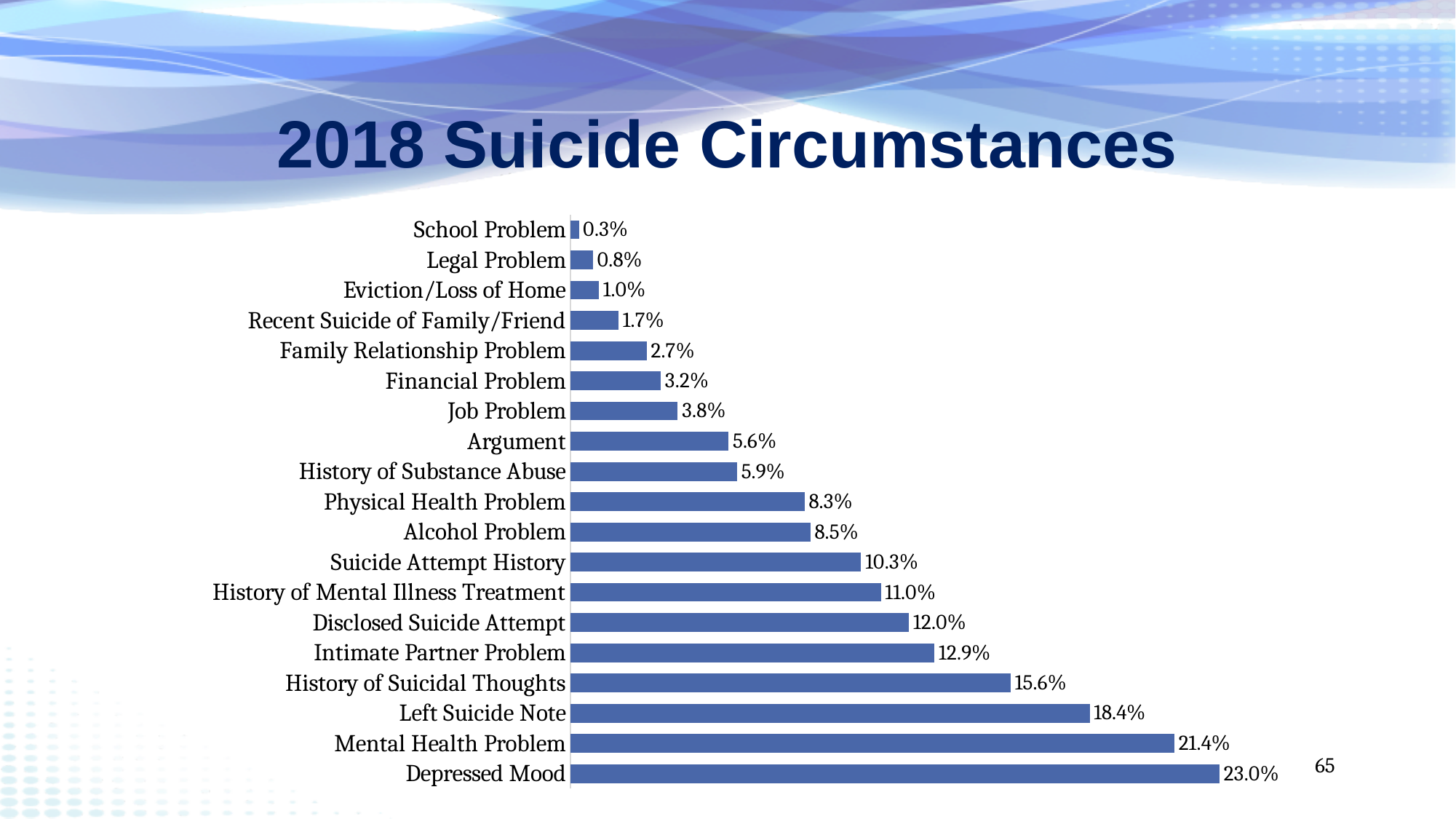
What is the value for Depressed Mood? 23.0% How many circumstances are shown in the chart? 19 What is the difference between Mental Health Problem and Left Suicide Note? 3.0% What is the difference between History of Suicidal Thoughts and Intimate Partner Problem? 2.7% Which is larger, Alcohol Problem or Physical Health Problem? Alcohol Problem What is the title of the slide? 2018 Suicide Circumstances Which circumstance has the lowest value? School Problem Which is larger, Job Problem or Argument? Argument What kind of chart is shown on the slide? Bar chart What is the value for Suicide Attempt History? 10.3% Which circumstance has the highest value? Depressed Mood What is the value for Financial Problem? 3.2%